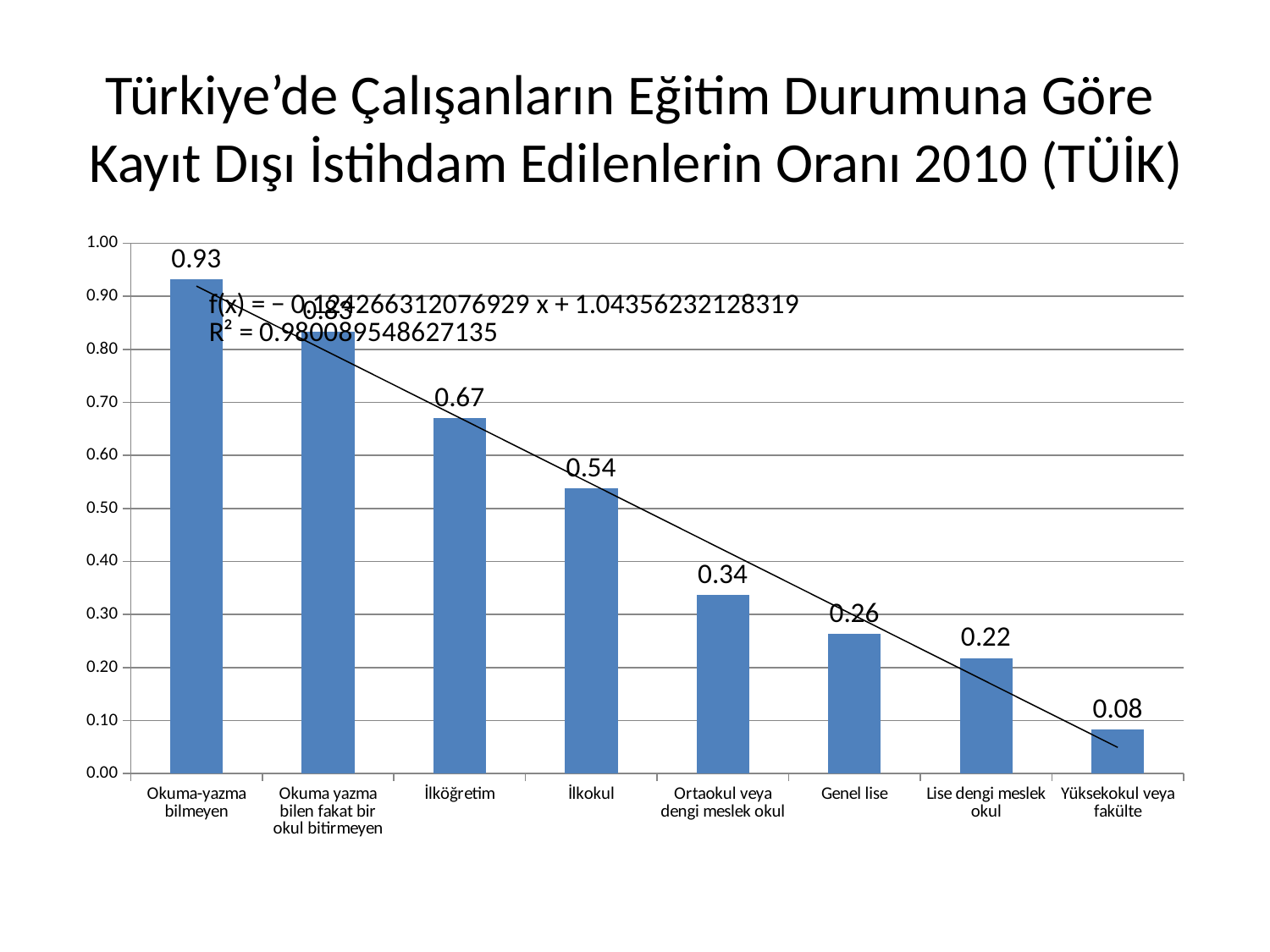
Which category has the highest value? Okuma-yazma bilmeyen What is the value for Yüksekokul veya fakülte? 0.08 What kind of chart is shown on the slide? bar chart Is the value for İlkokul greater or less than 0.50? greater Which category has the lowest value? Yüksekokul veya fakülte Which is larger, the value for Genel lise or the value for Lise dengi meslek okul? Genel lise What is the value for Okuma-yazma bilmeyen? 0.93 Do the values rise or fall from left to right along the x axis? fall How many categories are shown on the x axis? 8 What is the value for Ortaokul veya dengi meslek okul? 0.34 What is the difference between the values for İlkokul and Genel lise? 0.28 What is the value for İlköğretim? 0.67